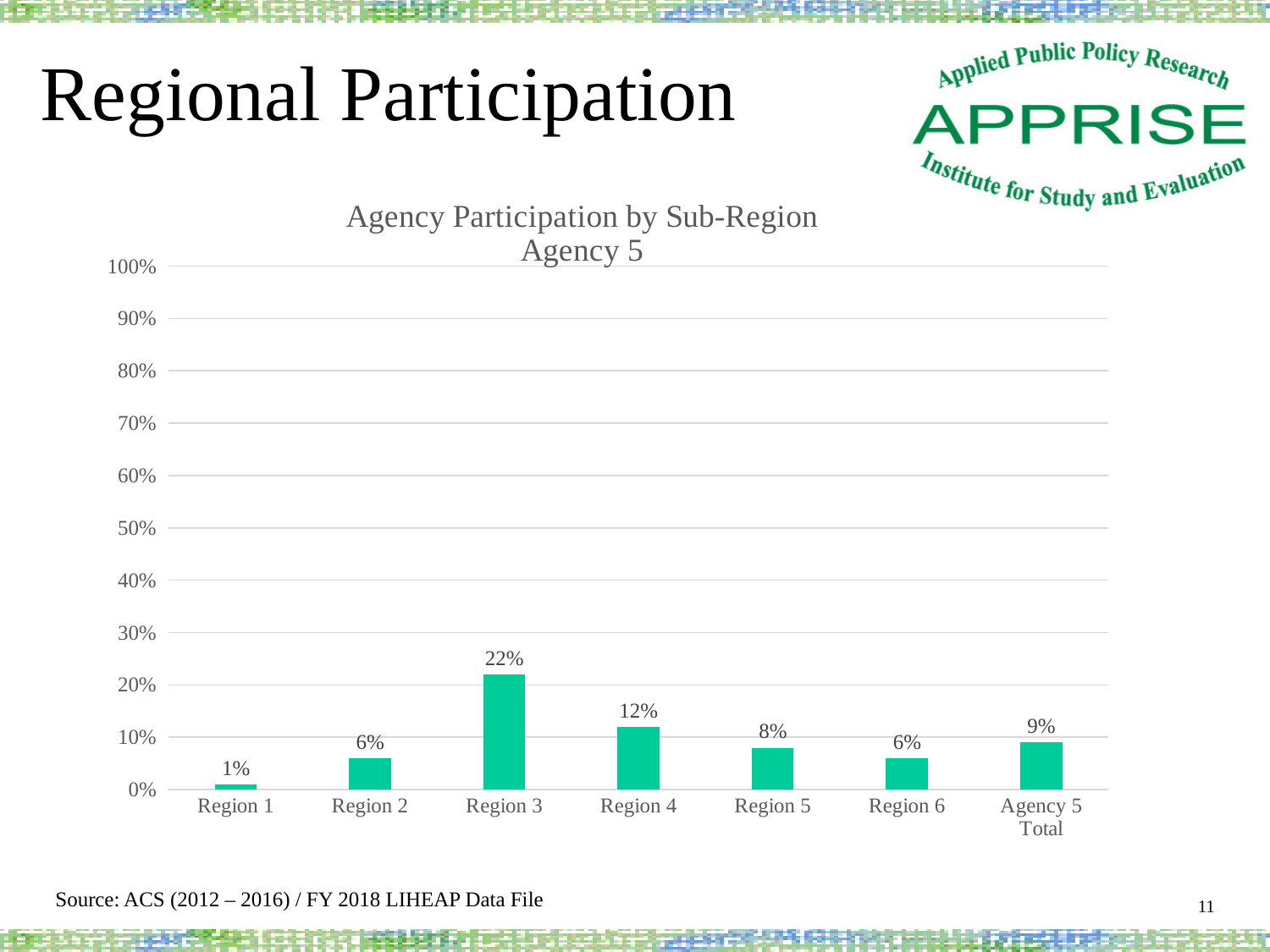
What is the value shown for Agency 5 Total? 9% Is the value for Region 3 greater or less than 20%? greater What is the difference between the values for Region 5 and Region 1? 7% What is the difference between the values for Region 3 and Region 4? 10% Which region has the lowest participation? Region 1 What kind of chart is shown on the slide? Bar chart What is the title of the chart? Agency Participation by Sub-Region Agency 5 Which is larger, the value for Region 4 or the value for Region 6? Region 4 How many categories are shown on the x axis? 7 What is the participation value for Region 1? 1% What is the participation value for Region 3? 22% Which region has the highest participation? Region 3